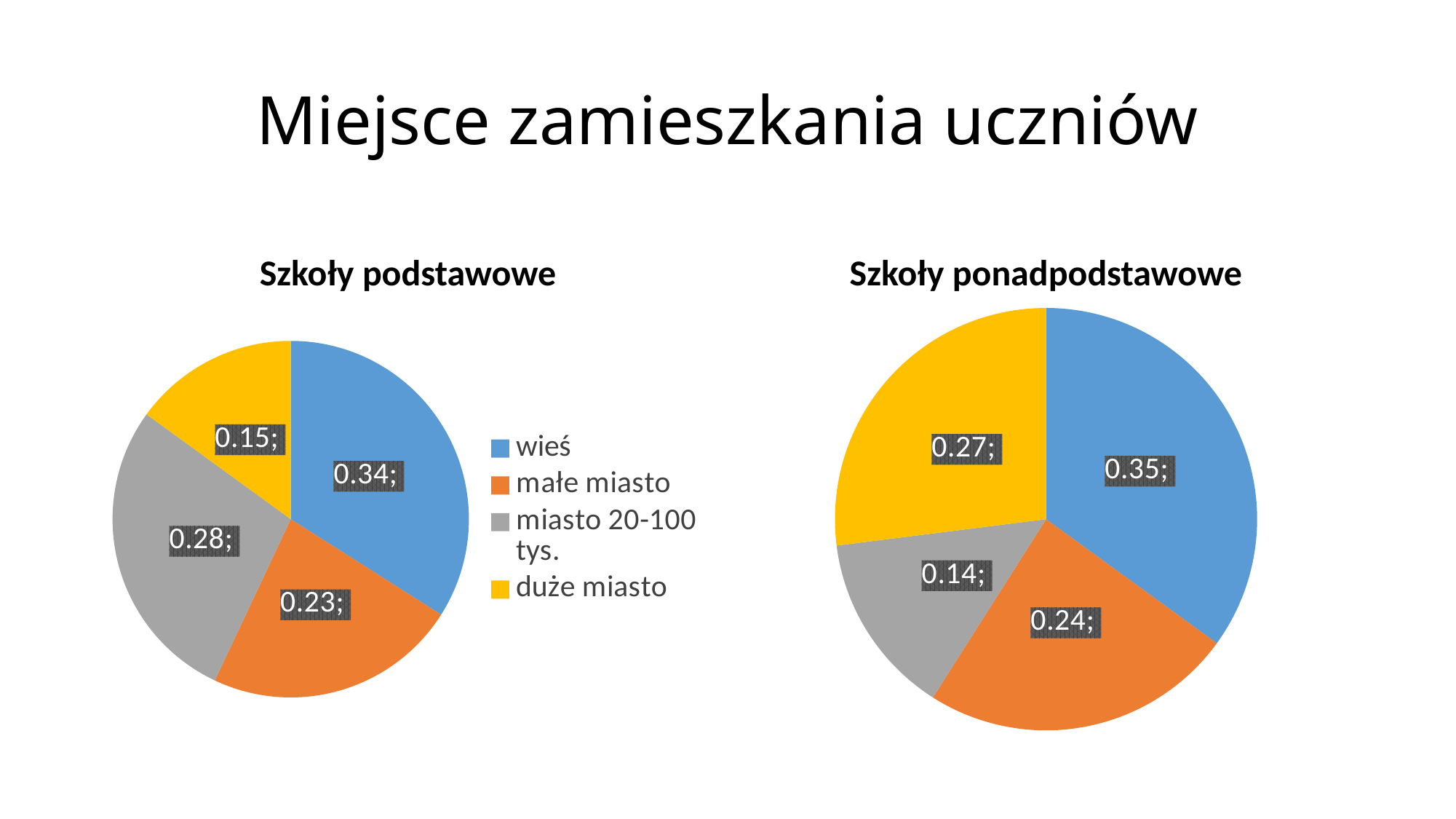
Which colour represents duże miasto in the legend? yellow In the 'Szkoły podstawowe' chart, what is the value for duże miasto? 0.15 How many entries does the legend list? 4 In the 'Szkoły podstawowe' chart, what is the difference between the values for miasto 20-100 tys. and duże miasto? 0.13 In the 'Szkoły ponadpodstawowe' chart, which is larger: the value for duże miasto or the value for małe miasto? duże miasto What type of chart is used for 'Szkoły ponadpodstawowe'? pie chart In the 'Szkoły ponadpodstawowe' chart, what is the value for miasto 20-100 tys.? 0.14 How many slices does the 'Szkoły podstawowe' pie chart have? 4 In the 'Szkoły podstawowe' chart, which category has the largest slice? wieś In the 'Szkoły ponadpodstawowe' chart, which category has the smallest slice? miasto 20-100 tys. In the 'Szkoły podstawowe' chart, what is the value for wieś? 0.34 In the 'Szkoły ponadpodstawowe' chart, what is the value for małe miasto? 0.24